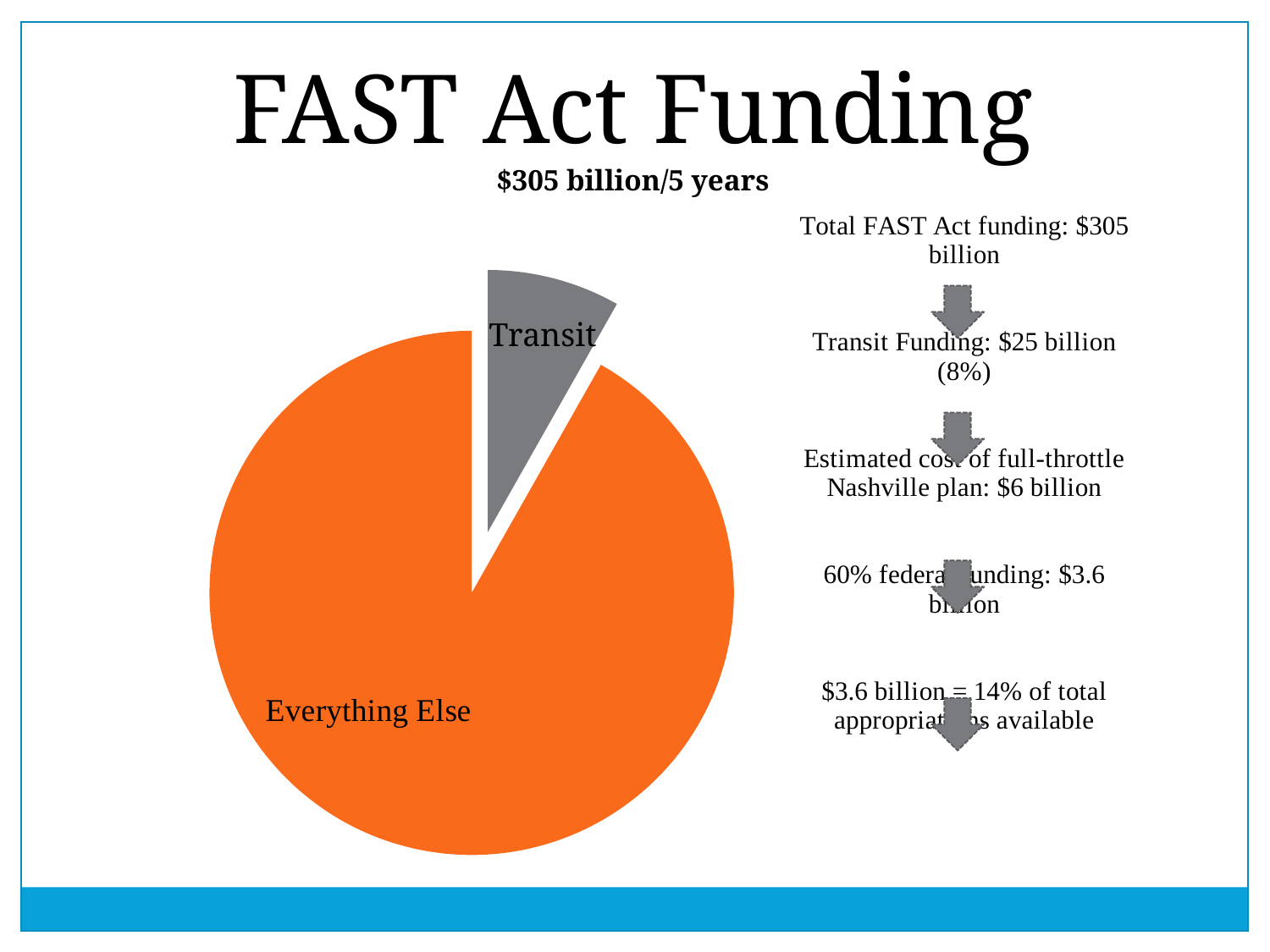
What share of the pie does the Transit slice represent, according to the slide? 8% What kind of chart is shown on the slide? pie chart Which slice of the pie chart is the largest? Everything Else How many slices does the pie chart have? 2 Which slice of the pie chart is the smallest? Transit Which is larger in the pie chart, Transit or Everything Else? Everything Else What is the subtitle shown above the pie chart? $305 billion/5 years What colour is the Transit slice in the pie chart? gray